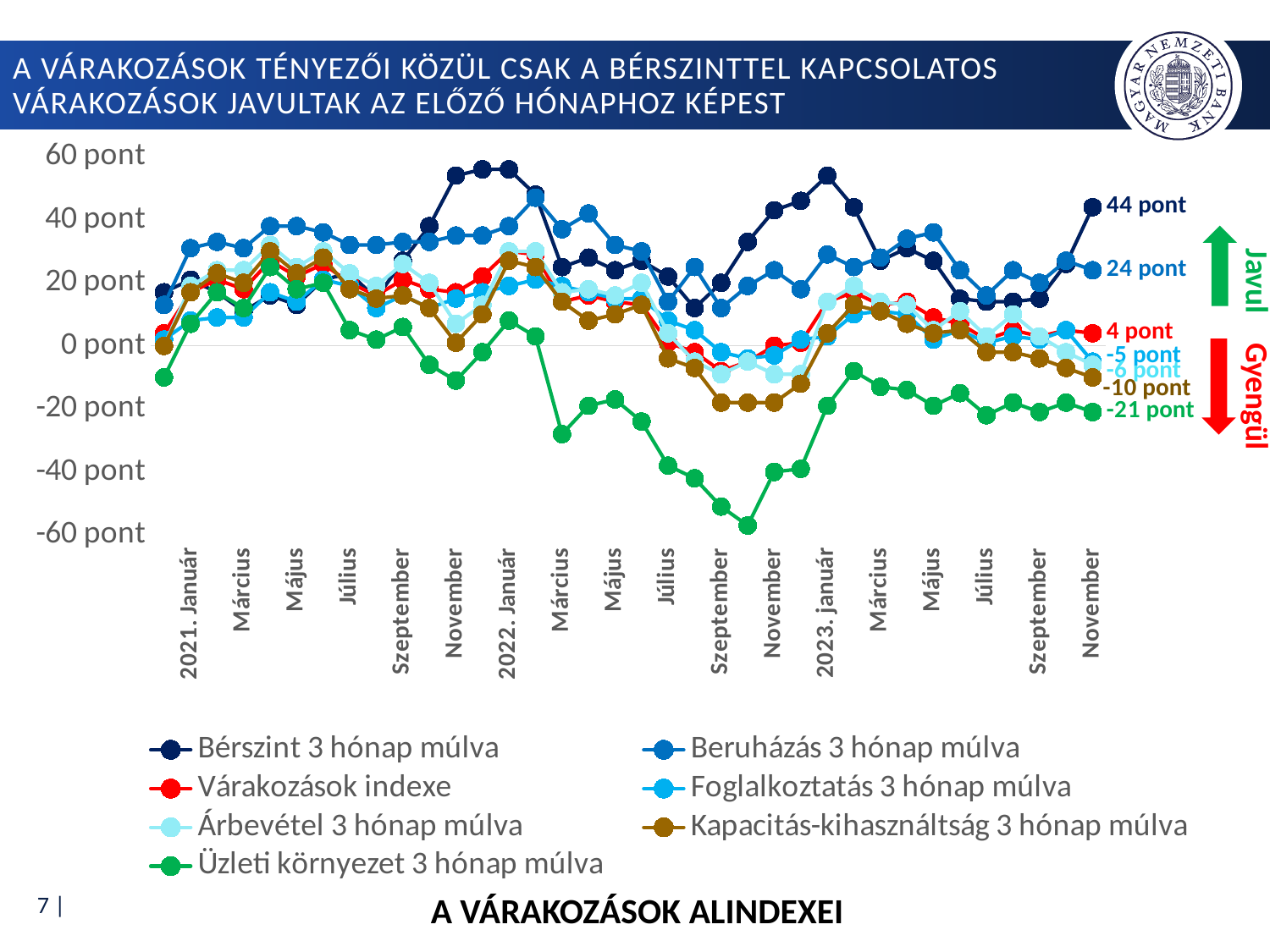
What is the final labelled value for the 'Kapacitás-kihasználtság 3 hónap múlva' series? -10 pont What is the final labelled value for the 'Bérszint 3 hónap múlva' series? 44 pont What is the difference between the final labelled values of 'Bérszint 3 hónap múlva' and 'Beruházás 3 hónap múlva'? 20 pont What is the final labelled value for the 'Várakozások indexe' series? 4 pont Is the lowest point of the 'Üzleti környezet 3 hónap múlva' series greater or less than -40 pont? less Which series has the lowest labelled value at the end of the chart? Üzleti környezet 3 hónap múlva Which series has the highest labelled value at the end of the chart? Bérszint 3 hónap múlva How many series does the legend list? 7 What is the title shown below the chart? A VÁRAKOZÁSOK ALINDEXEI What is the final labelled value for the 'Beruházás 3 hónap múlva' series? 24 pont What kind of chart is shown on the slide? line chart What is the final labelled value for the 'Üzleti környezet 3 hónap múlva' series? -21 pont